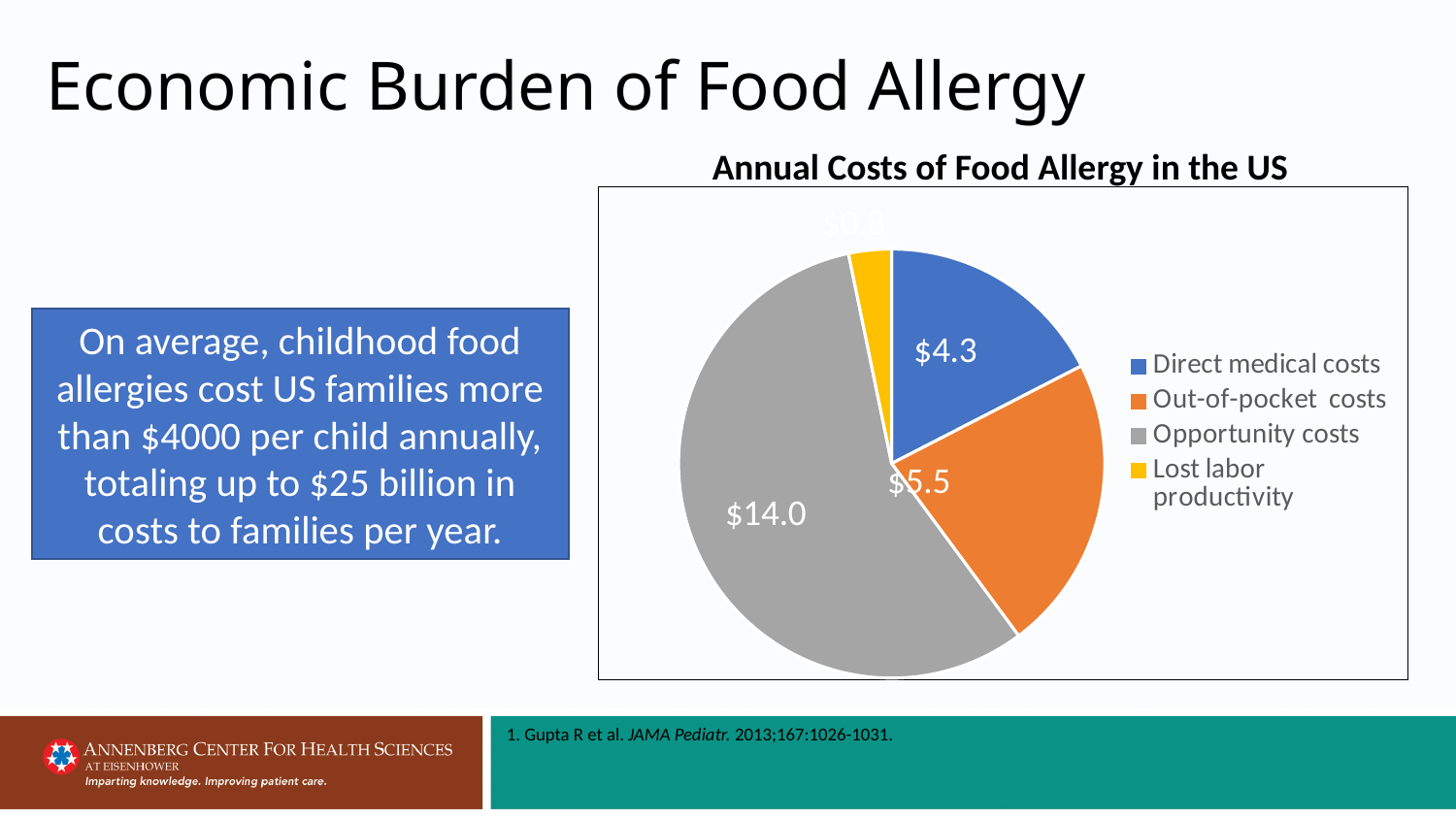
Which category has the smallest slice in the pie chart? Lost labor productivity What kind of chart is shown on the slide? Pie chart What is the difference between the Opportunity costs value and the Direct medical costs value? $9.7 What is the value shown for Opportunity costs in the pie chart? $14.0 How many entries does the legend of the pie chart list? 4 What is the value shown for Direct medical costs in the pie chart? $4.3 How many slices does the pie chart have? 4 What is the value shown for Out-of-pocket costs in the pie chart? $5.5 What is the difference between the Out-of-pocket costs value and the Direct medical costs value? $1.2 Which category has the largest slice in the pie chart? Opportunity costs Which is larger, Out-of-pocket costs or Direct medical costs? Out-of-pocket costs What is the title of the chart on the slide? Annual Costs of Food Allergy in the US